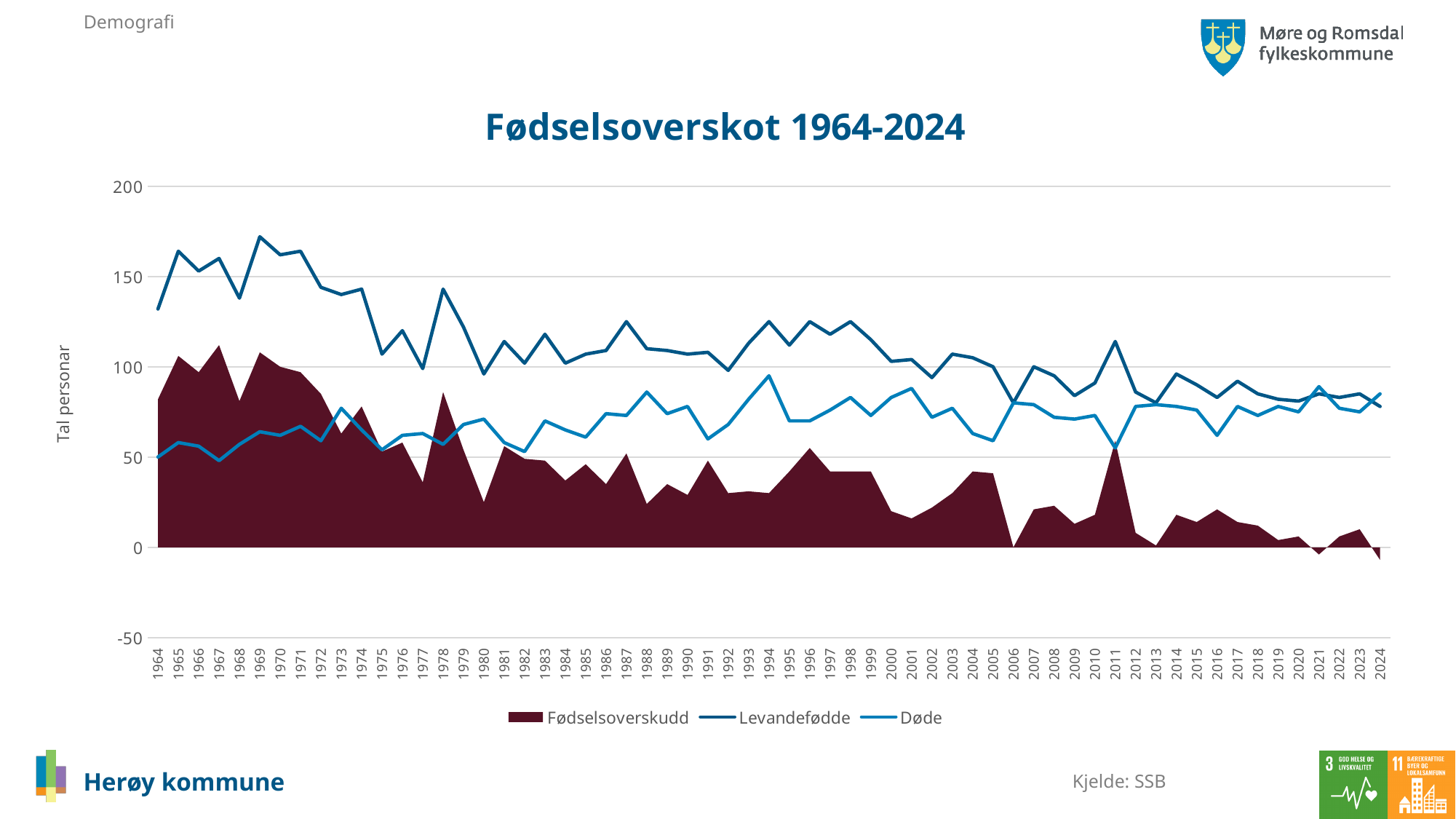
How many series does the chart legend list? 3 Is the value for Døde in 1964 greater or less than 100? less How many years are plotted along the x axis of the chart? 61 Is the value for Døde in 1994 greater or less than 50? greater Is the value for Levandefødde in 2024 greater or less than 100? less What is the title of the chart? Fødselsoverskot 1964-2024 Does the Levandefødde series generally rise or fall from 1964 to 2024? fall In which year does the Levandefødde series reach its highest value? 1969 What is the label on the vertical axis of the chart? Tal personar In 1964, which is larger: Levandefødde or Døde? Levandefødde